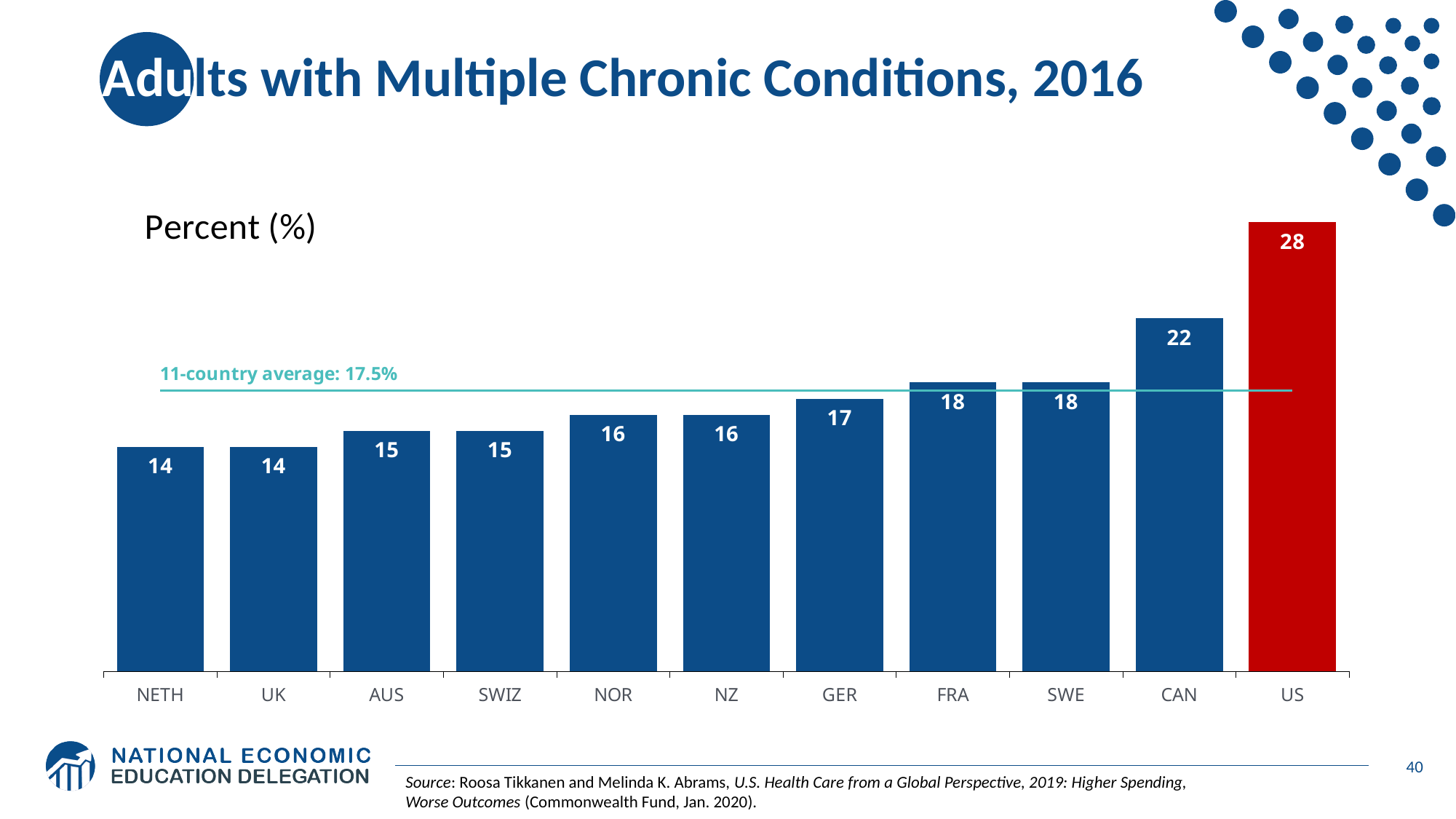
Which country has the highest value? US How many countries are shown on the chart? 11 What kind of chart is shown on the slide? bar chart Do the values generally rise or fall from NETH to US along the x axis? rise Which is larger, the value for NOR or the value for FRA? FRA What is the difference between the values for CAN and NETH? 8 What is the value for the US? 28 What is the 11-country average shown on the chart? 17.5% What is the value for CAN? 22 What is the value for GER? 17 What is the difference between the values for the US and CAN? 6 Which country's bar is coloured red? US